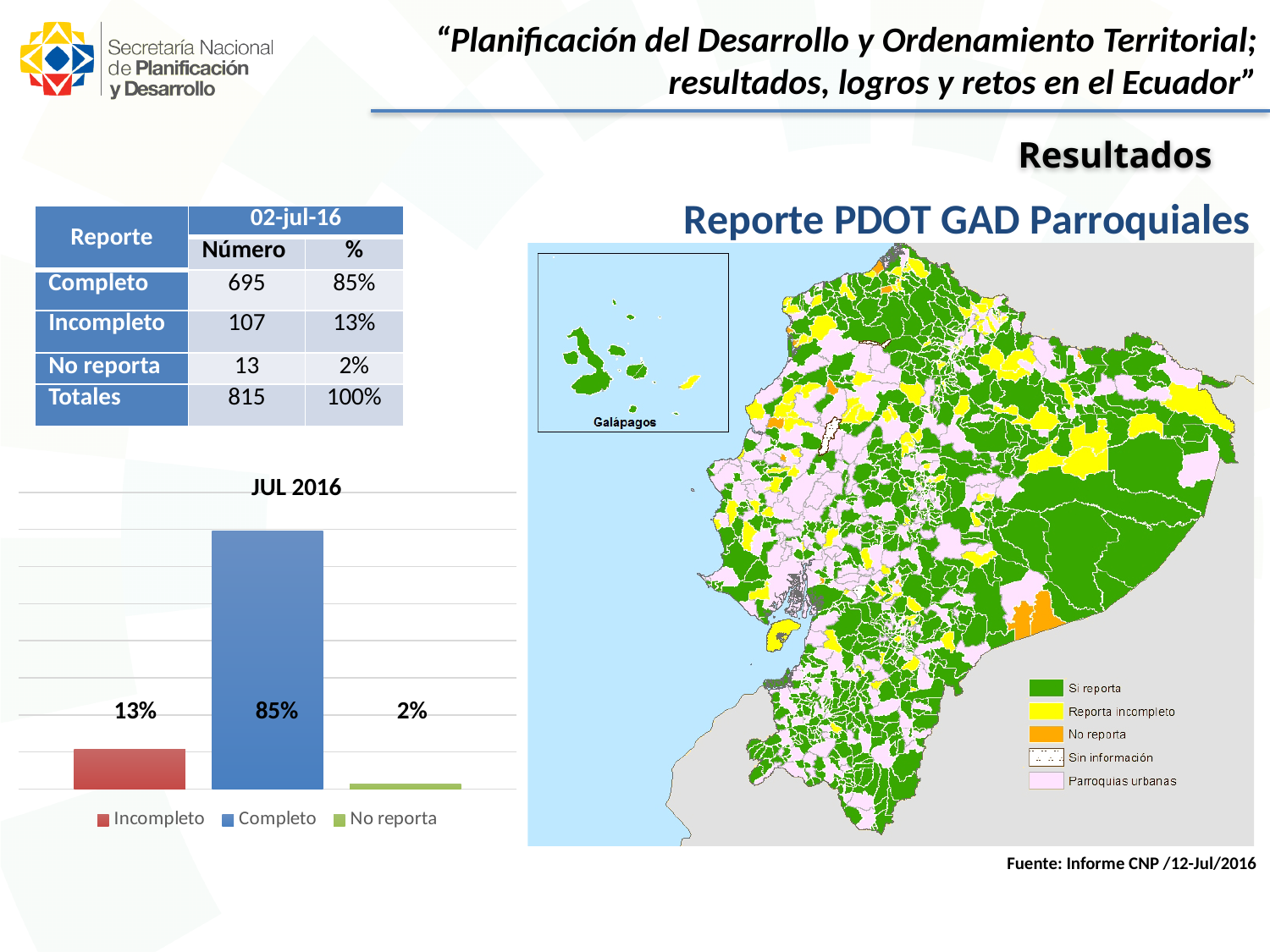
Which series has the highest value in the JUL 2016 bar chart? Completo In the JUL 2016 bar chart, what is the difference between the Completo and Incompleto values? 72% What is the value shown for No reporta in the JUL 2016 bar chart? 2% In the JUL 2016 bar chart, which is larger: Incompleto or No reporta? Incompleto How many bars are plotted in the JUL 2016 chart? 3 What colour is the Completo bar in the JUL 2016 chart? Blue What type of chart is the JUL 2016 chart? Bar chart What is the value shown for Incompleto in the JUL 2016 bar chart? 13% In the JUL 2016 bar chart, what is the difference between the Incompleto and No reporta values? 11% Which series has the lowest value in the JUL 2016 bar chart? No reporta How many series does the legend of the JUL 2016 chart list? 3 What is the value shown for Completo in the JUL 2016 bar chart? 85%